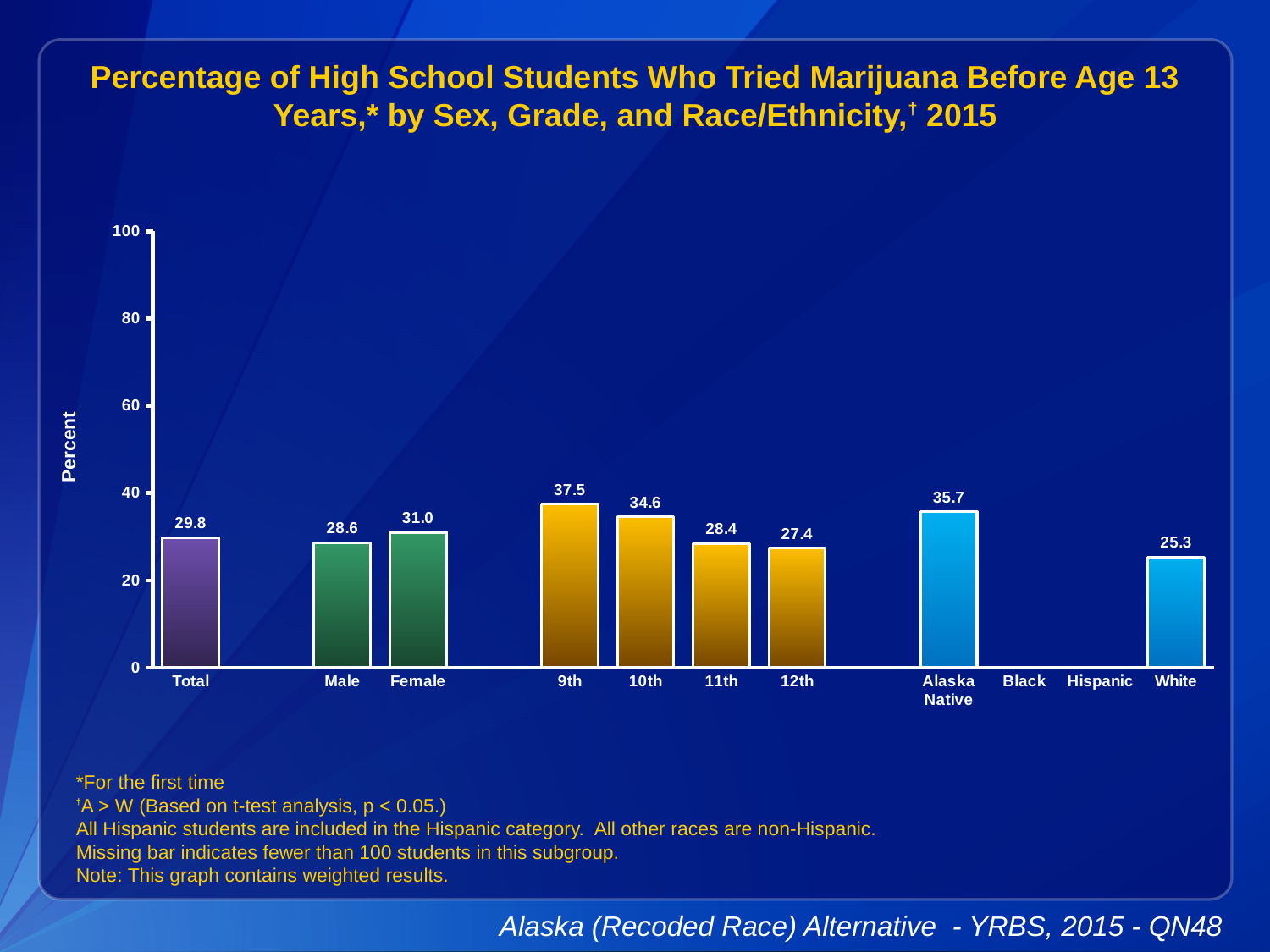
What is the difference between the values for 9th and 12th? 10.1 Which category with a bar has the lowest value? White What kind of chart is shown? bar chart Is the value for 11th greater or less than 40? less What is the value for Alaska Native? 35.7 Do the values rise or fall from 9th grade to 12th grade? fall How many categories are labeled on the x axis? 11 What is the value for Total? 29.8 What is the difference between the values for Male and Female? 2.4 Which category has the highest value? 9th What is the value for Female? 31.0 Which is larger, the value for 10th or the value for Alaska Native? Alaska Native